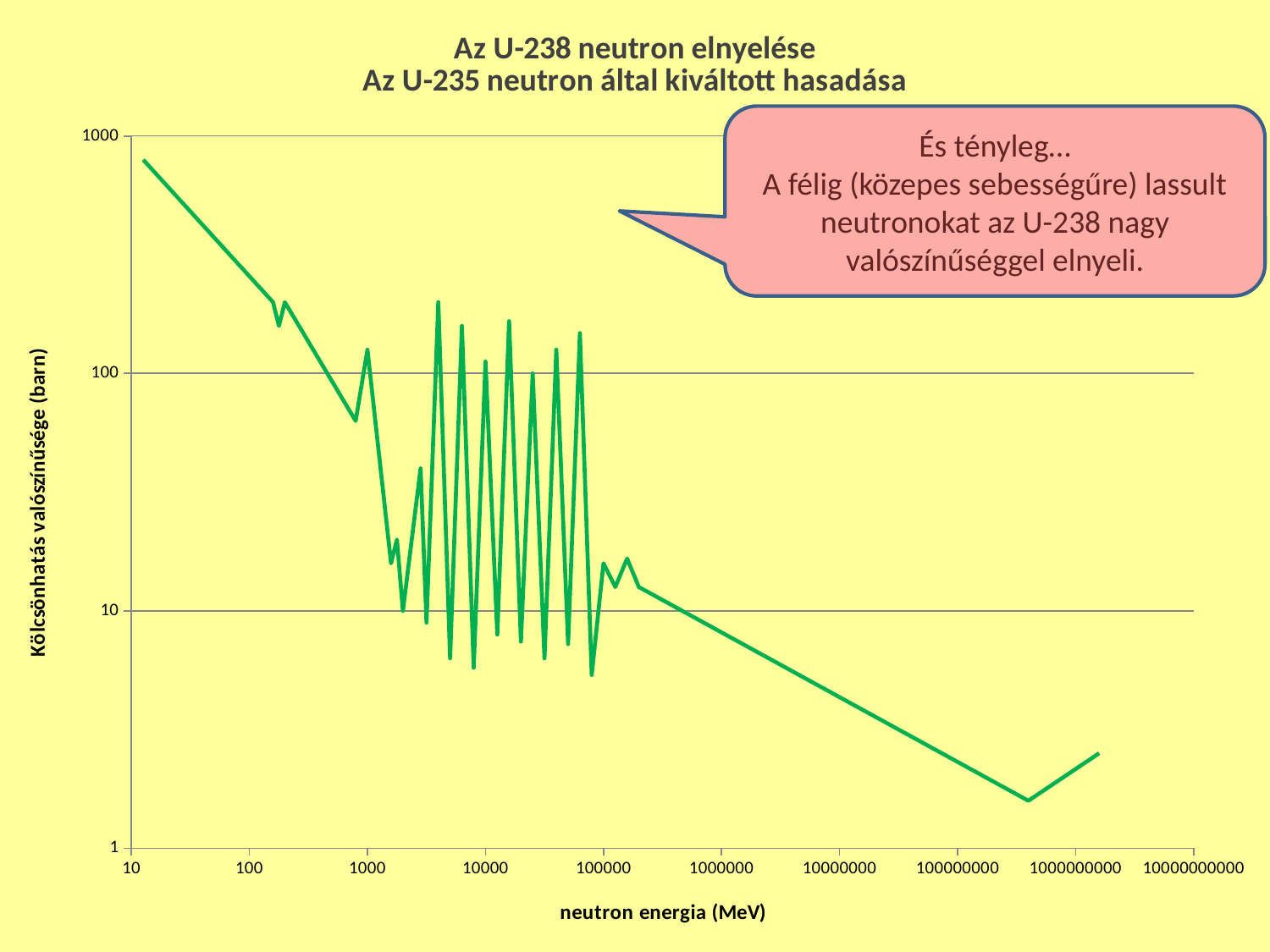
What is the title of the chart? Az U-238 neutron elnyelése Az U-235 neutron által kiváltott hasadása Overall, does the plotted value rise or fall as neutron energy increases along the x axis? fall Is the value at 100 MeV greater or less than 100? greater Is the value at the left end of the line (near 10 MeV) greater or less than 100? greater How many lines are plotted on the chart? 1 Is the value at 100000000 MeV greater or less than 1? greater What is the label of the x axis? neutron energia (MeV) Which is larger, the value at 100 MeV or the value at 1000000 MeV? the value at 100 MeV What is the highest tick value shown on the y axis? 1000 What kind of chart is shown on the slide? line chart